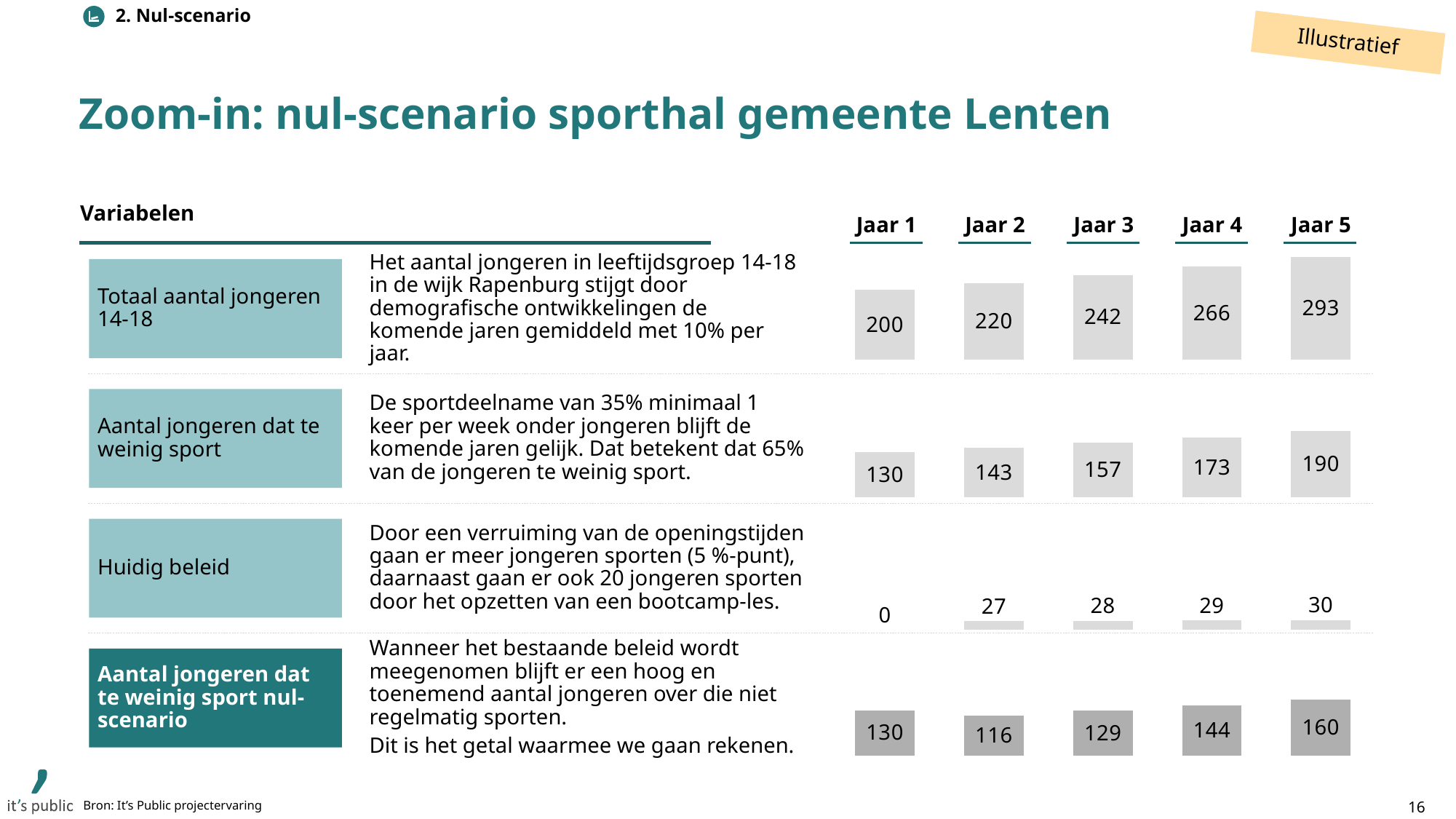
In the 'Totaal aantal jongeren 14-18' row, what is the value for Jaar 3? 242 How many years (categories) are shown in each row of bars? 5 In the 'Aantal jongeren dat te weinig sport nul-scenario' row, what is the difference between Jaar 5 and Jaar 4? 16 In the 'Huidig beleid' row, what is the value for Jaar 1? 0 In the 'Aantal jongeren dat te weinig sport' row, which is larger: Jaar 2 or Jaar 4? Jaar 4 In the 'Totaal aantal jongeren 14-18' row, what is the difference between Jaar 5 and Jaar 1? 93 In the 'Totaal aantal jongeren 14-18' row, do the values rise or fall from Jaar 1 to Jaar 5? Rise In the 'Aantal jongeren dat te weinig sport' row, what is the value for Jaar 5? 190 In the 'Aantal jongeren dat te weinig sport nul-scenario' row, what is the value for Jaar 2? 116 In the 'Totaal aantal jongeren 14-18' row, which year has the highest value? Jaar 5 In the 'Aantal jongeren dat te weinig sport nul-scenario' row, which year has the lowest value? Jaar 2 What kind of chart is used to show the values per year in each row? Bar chart